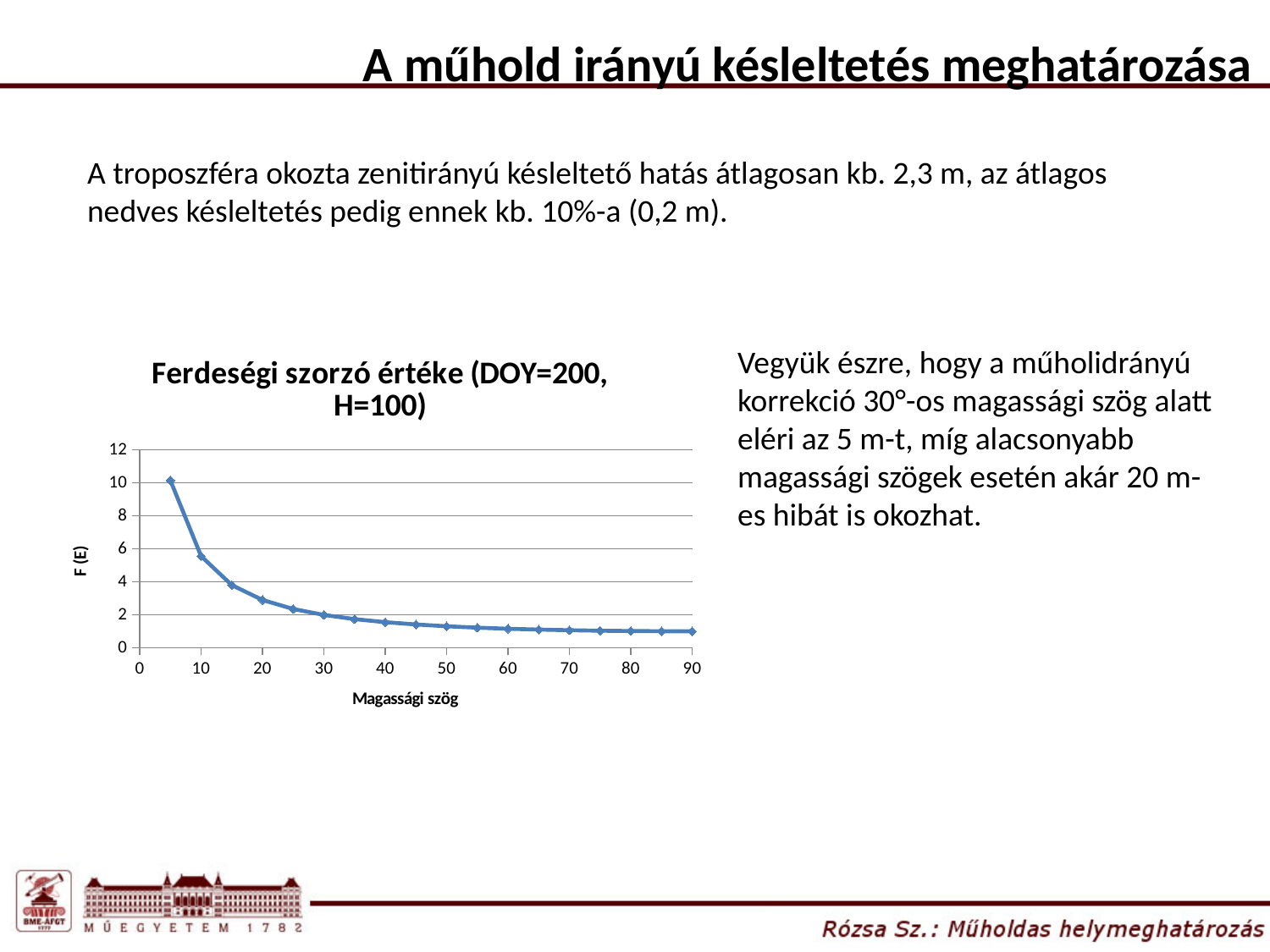
What is the maximum value shown on the y axis of the chart? 12 How many data points are plotted on the line? 18 At which Magassági szög value is F (E) highest? 5 What is the title of the chart? Ferdeségi szorzó értéke (DOY=200, H=100) Is the value of F (E) at Magassági szög 5 greater or less than 8? greater What is the label of the x axis of the chart? Magassági szög Which has a larger F (E) value: Magassági szög 10 or Magassági szög 20? Magassági szög 10 What kind of chart is shown on the slide? line chart Is the value of F (E) at Magassági szög 20 greater or less than 4? less Do the values of F (E) rise or fall as the Magassági szög increases along the x axis? fall Is the value of F (E) at Magassági szög 10 greater or less than 4? greater